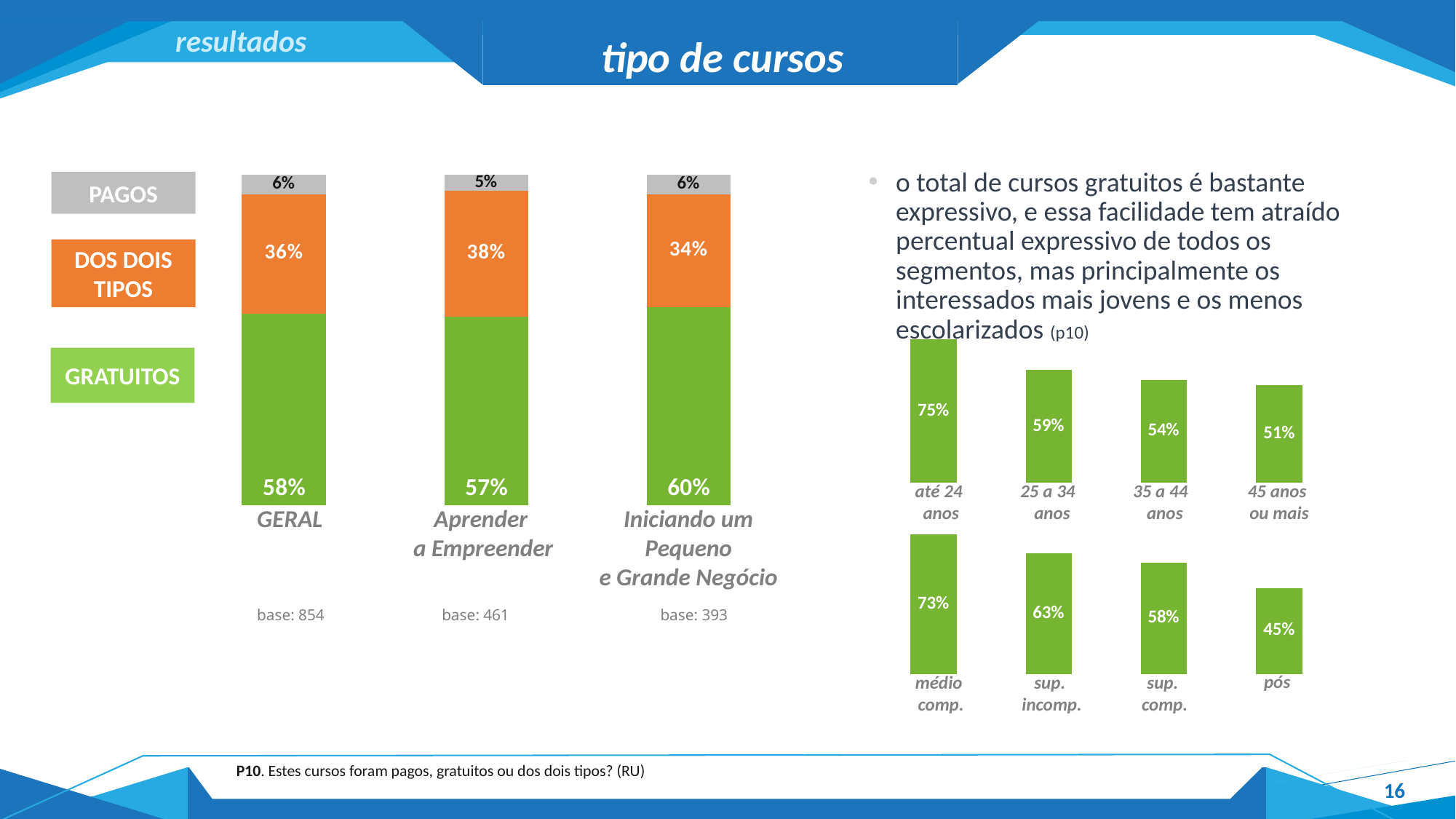
In the stacked bar chart on the left, what is the PAGOS share for Iniciando um Pequeno e Grande Negócio? 6% In the stacked bar chart on the left, what is the total of the GERAL bar? 100% In the stacked bar chart on the left, what is the difference between the DOS DOIS TIPOS shares for Aprender a Empreender and Iniciando um Pequeno e Grande Negócio? 4% In the age-group bar chart on the right, what is the value for até 24 anos? 75% In the stacked bar chart on the left, what is the GRATUITOS share for GERAL? 58% In the education-level bar chart on the right, do the values rise or fall from médio comp. to pós? fall In the stacked bar chart on the left, which category has the highest GRATUITOS share? Iniciando um Pequeno e Grande Negócio In the stacked bar chart on the left, how many series does the legend list? 3 In the age-group bar chart on the right, which age group has the lowest value? 45 anos ou mais In the stacked bar chart on the left, what is the DOS DOIS TIPOS share for Aprender a Empreender? 38% In the education-level bar chart on the right, what is the value for pós? 45% In the education-level bar chart on the right, which is larger, the value for sup. incomp. or sup. comp.? sup. incomp.